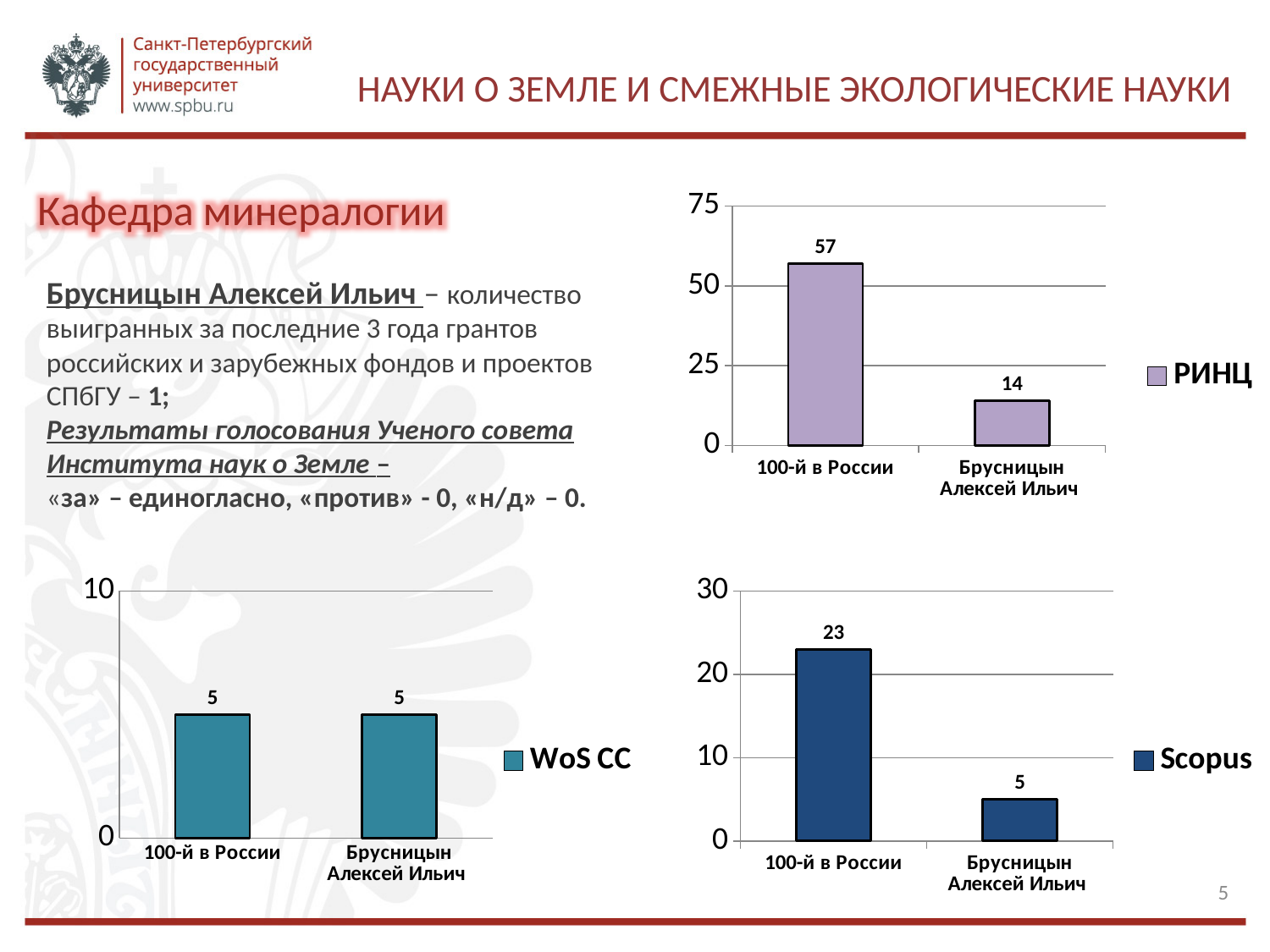
In the РИНЦ chart (top right), what is the value for Брусницын Алексей Ильич? 14 In the Scopus chart (bottom right), what is the value for Брусницын Алексей Ильич? 5 In the РИНЦ chart (top right), what is the value for 100-й в России? 57 In the Scopus chart (bottom right), what is the value for 100-й в России? 23 In the Scopus chart (bottom right), which category has the highest value? 100-й в России In the WoS CC chart (bottom left), is the value for 100-й в России greater or less than the value for Брусницын Алексей Ильич? equal How many categories are shown in the Scopus chart (bottom right)? 2 In the WoS CC chart (bottom left), what is the value for Брусницын Алексей Ильич? 5 In the РИНЦ chart (top right), what is the difference between the value for 100-й в России and the value for Брусницын Алексей Ильич? 43 In the РИНЦ chart (top right), is the value for 100-й в России greater or less than 50? greater In the Scopus chart (bottom right), what is the difference between the two bars? 18 What type of chart is the WoS CC chart (bottom left)? bar chart